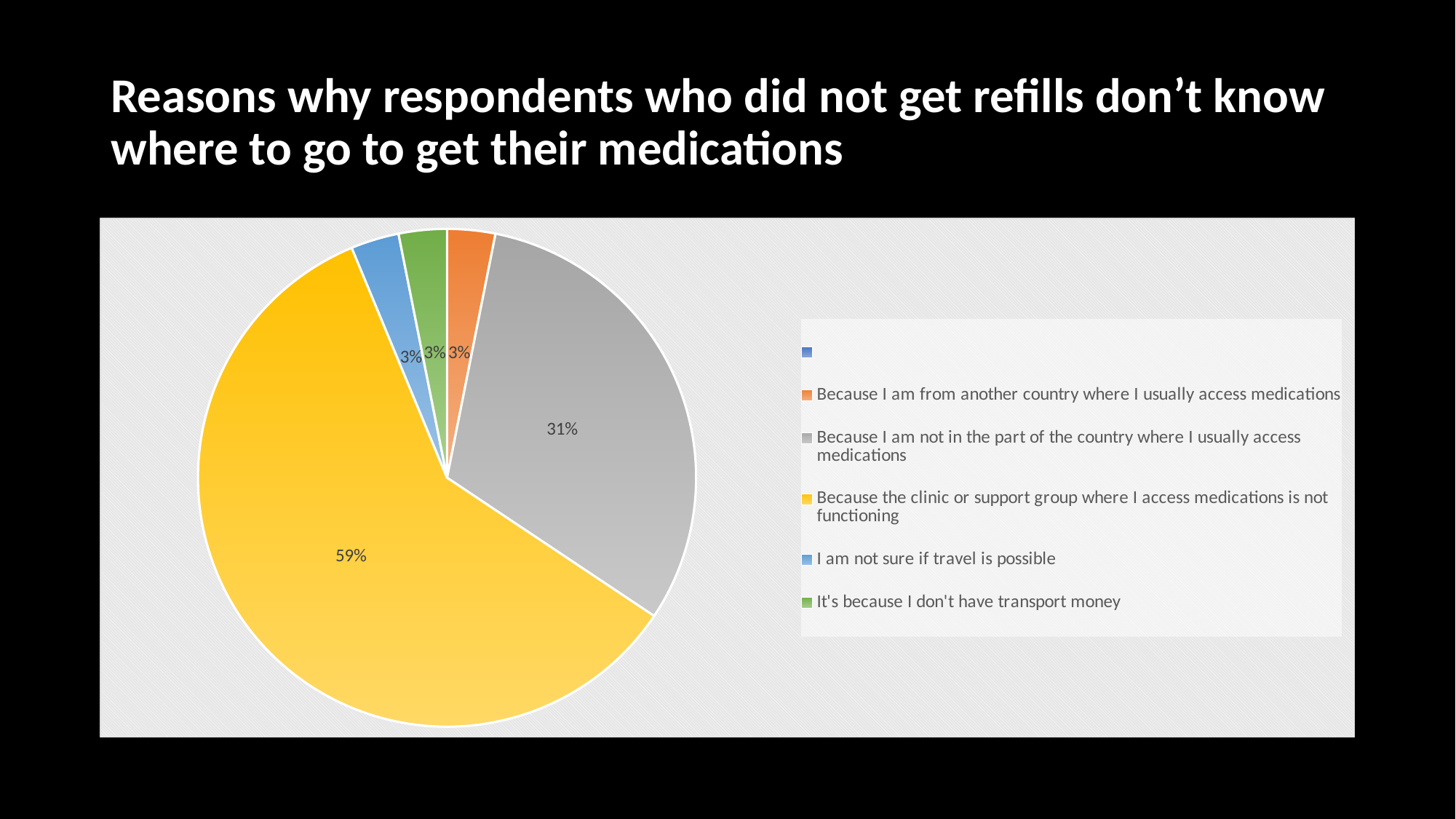
What share of the pie is labelled for "Because I am not in the part of the country where I usually access medications"? 31% What share of the pie is labelled for "Because the clinic or support group where I access medications is not functioning"? 59% What percentage is shown for "I am not sure if travel is possible"? 3% What is the difference between the 59% slice and the 31% slice? 28 percentage points What kind of chart is shown on the slide? Pie chart What percentage is shown for "It's because I don't have transport money"? 3% Which reason has the largest slice of the pie? Because the clinic or support group where I access medications is not functioning What is the title of the slide? Reasons why respondents who did not get refills don't know where to go to get their medications Which is larger: the slice for "Because the clinic or support group where I access medications is not functioning" or the slice for "Because I am not in the part of the country where I usually access medications"? Because the clinic or support group where I access medications is not functioning What colour is the largest slice of the pie? Yellow What percentage is shown for "Because I am from another country where I usually access medications"? 3% How many slices of the pie have a percentage label? 5